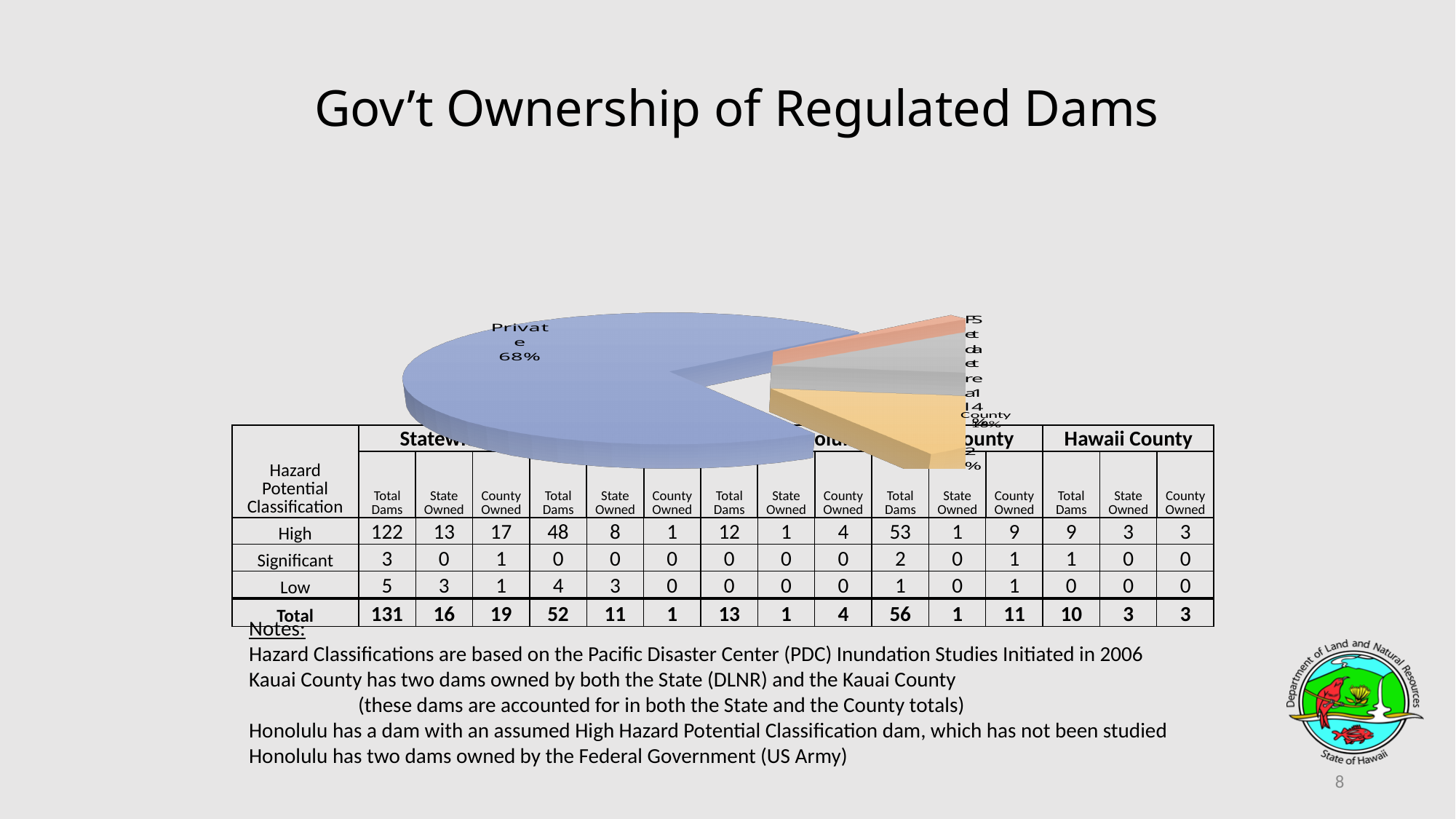
What colour is the Private slice of the pie chart? blue How many slices does the pie chart have? 4 What share of the pie does the Private slice represent? 68% Does the Private slice account for more or less than half of the pie? more Which slice of the pie chart is the largest? Private What kind of chart is shown on the slide? pie chart